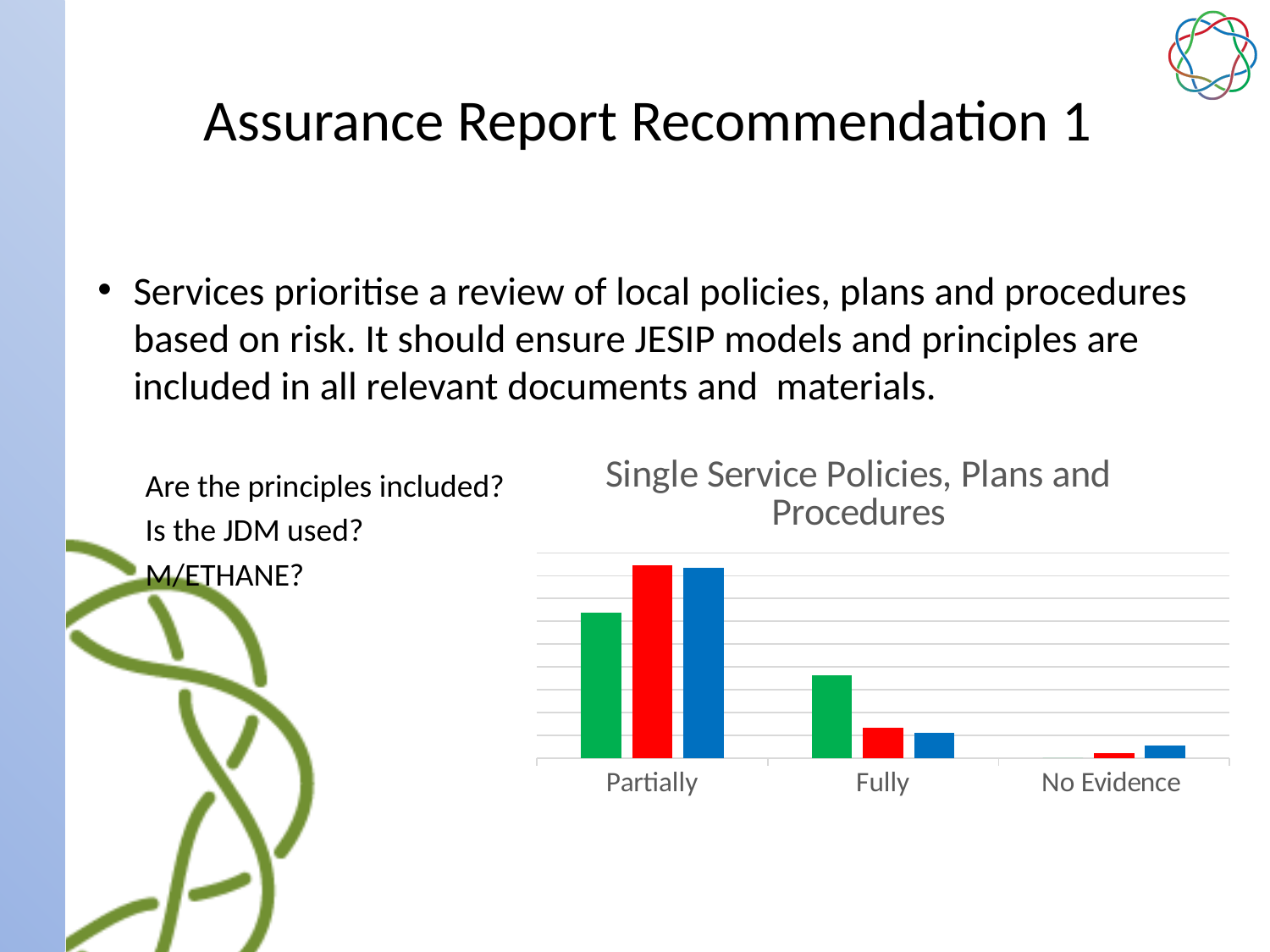
Is the green bar taller for Partially or for Fully? Partially What kind of chart is shown on the slide? Bar chart In the No Evidence category, is the red bar or the blue bar taller? Blue In the Partially category, is the green bar or the red bar taller? Red Do the bar heights rise or fall moving from Partially to No Evidence along the x axis? Fall How many categories are shown on the x axis of the chart? 3 Which category has the tallest bars in the chart? Partially How many bars are shown for the Partially category? 3 What colours are the bars in the chart? Green, red and blue What is the title of the chart? Single Service Policies, Plans and Procedures Which category has the shortest bars in the chart? No Evidence